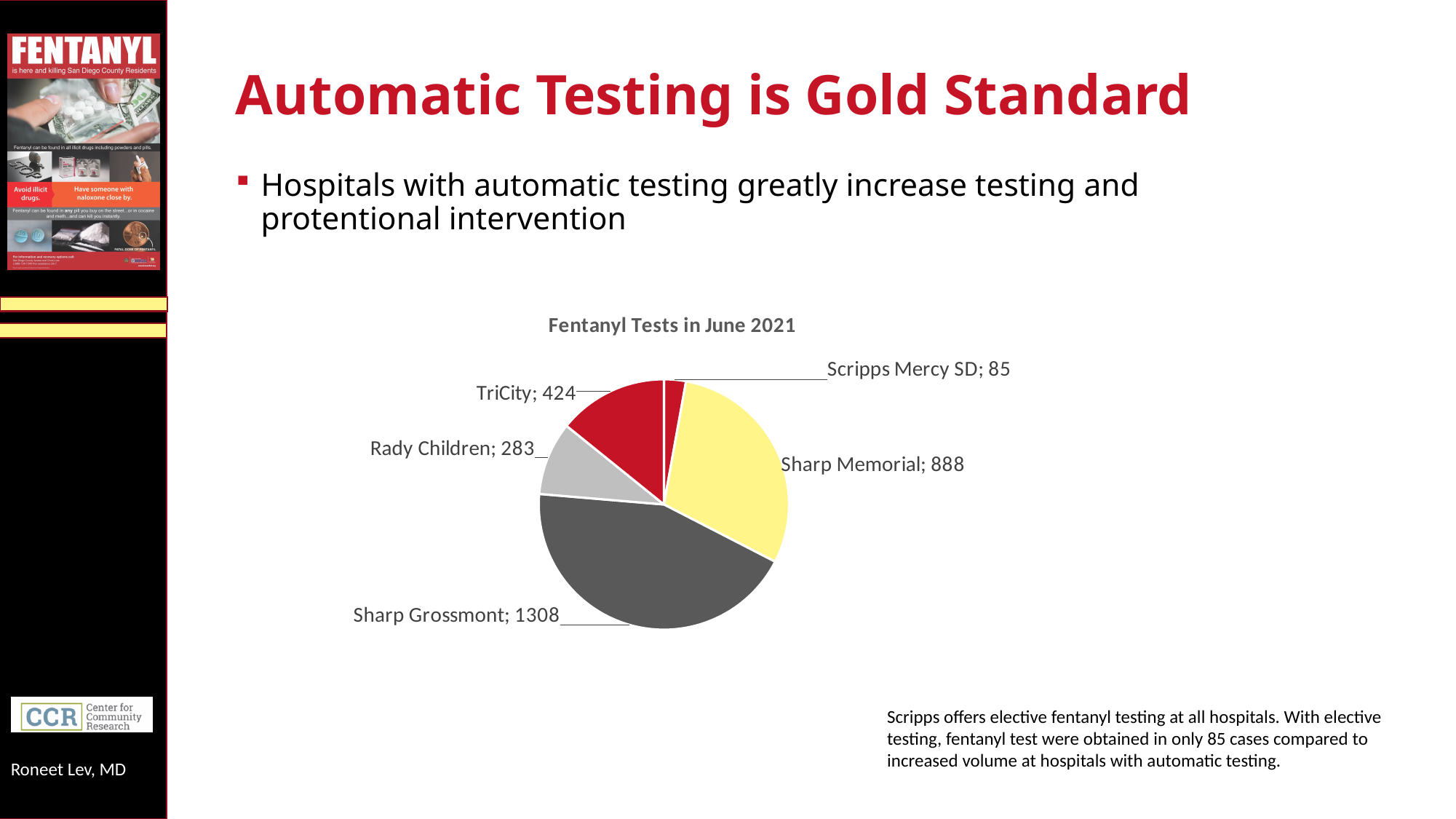
Which hospital has the largest slice of the pie? Sharp Grossmont What is the title of the pie chart? Fentanyl Tests in June 2021 Which has more fentanyl tests, TriCity or Rady Children? TriCity Which hospital has the smallest slice of the pie? Scripps Mercy SD What kind of chart is shown on the slide? pie chart What is the difference between the values for Sharp Grossmont and Sharp Memorial? 420 How many fentanyl tests did Sharp Grossmont have in June 2021? 1308 What is the difference between the values for Sharp Memorial and Scripps Mercy SD? 803 What is the value shown for Rady Children? 283 How many hospitals (slices) are shown in the pie chart? 5 What colour is the Sharp Memorial slice? yellow What is the value shown for Scripps Mercy SD? 85